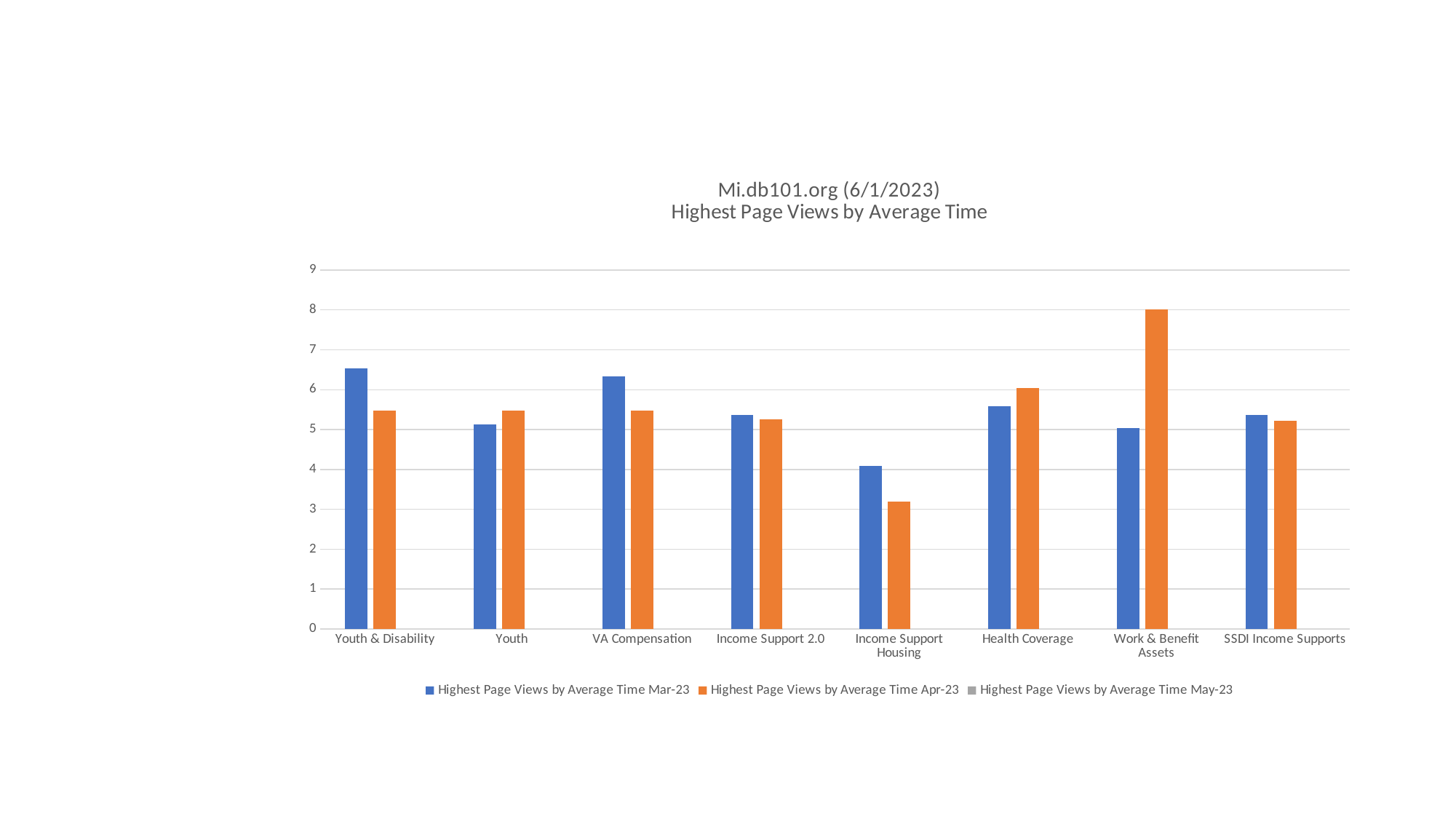
For Work & Benefit Assets, which series has the larger value, Mar-23 or Apr-23? Apr-23 For Income Support Housing, which series has the larger value, Mar-23 or Apr-23? Mar-23 What kind of chart is shown on the slide? bar chart Is the Apr-23 value for Income Support Housing greater or less than 4? less Which category has the lowest value for the Mar-23 series? Income Support Housing Is the Apr-23 value for Work & Benefit Assets greater or less than 7? greater Is the Mar-23 value for Youth & Disability greater or less than 6? greater How many series does the chart's legend list? 3 How many categories are shown on the x axis of the chart? 8 Which category has the highest value for the Apr-23 series? Work & Benefit Assets Which category has the lowest value for the Apr-23 series? Income Support Housing What is the title of the chart? Mi.db101.org (6/1/2023) Highest Page Views by Average Time